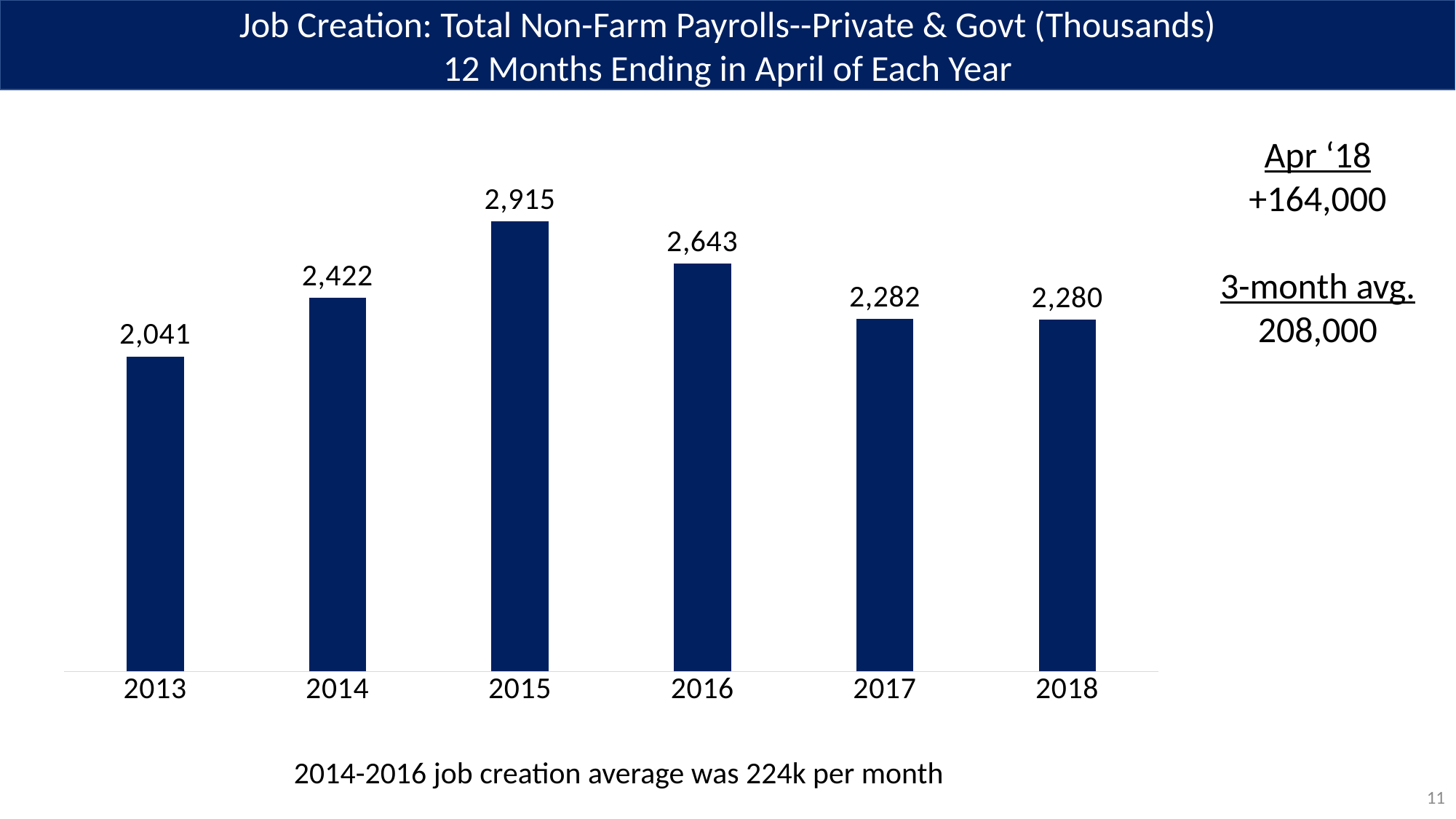
Which year has the highest value? 2015 Do the values rise or fall from 2013 to 2015? Rise Which is larger, the value for 2014 or the value for 2016? 2016 How many years are shown on the chart? 6 What is the value for 2015? 2,915 What is the title of the chart? Job Creation: Total Non-Farm Payrolls--Private & Govt (Thousands) 12 Months Ending in April of Each Year Which year has the lowest value? 2013 What kind of chart is shown on the slide? Bar chart What is the difference between the values for 2015 and 2016? 272 What is the value for 2018? 2,280 What is the difference between the values for 2014 and 2013? 381 What is the value for 2013? 2,041